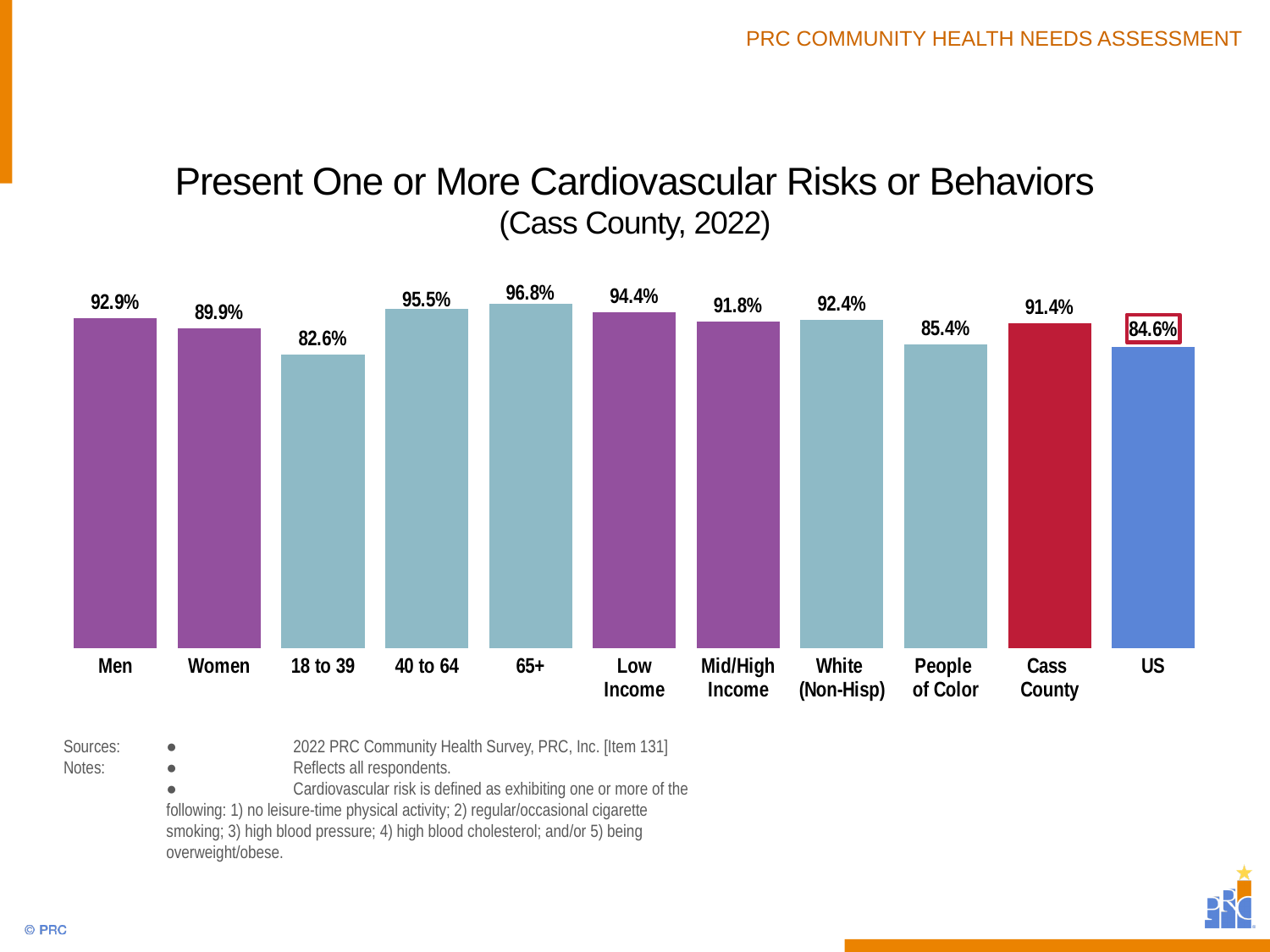
Which category has the lowest value? 18 to 39 How many categories are shown in the chart? 11 What is the title of the chart? Present One or More Cardiovascular Risks or Behaviors (Cass County, 2022) What is the value for 18 to 39? 82.6% What is the difference between the values for Men and Women? 3.0% What is the value for Cass County? 91.4% Which is larger, the value for Low Income or the value for Mid/High Income? Low Income What kind of chart is shown on the slide? Bar chart Which category has the highest value? 65+ What is the difference between the values for Cass County and US? 6.8% What is the value for US? 84.6% What is the value for Men? 92.9%